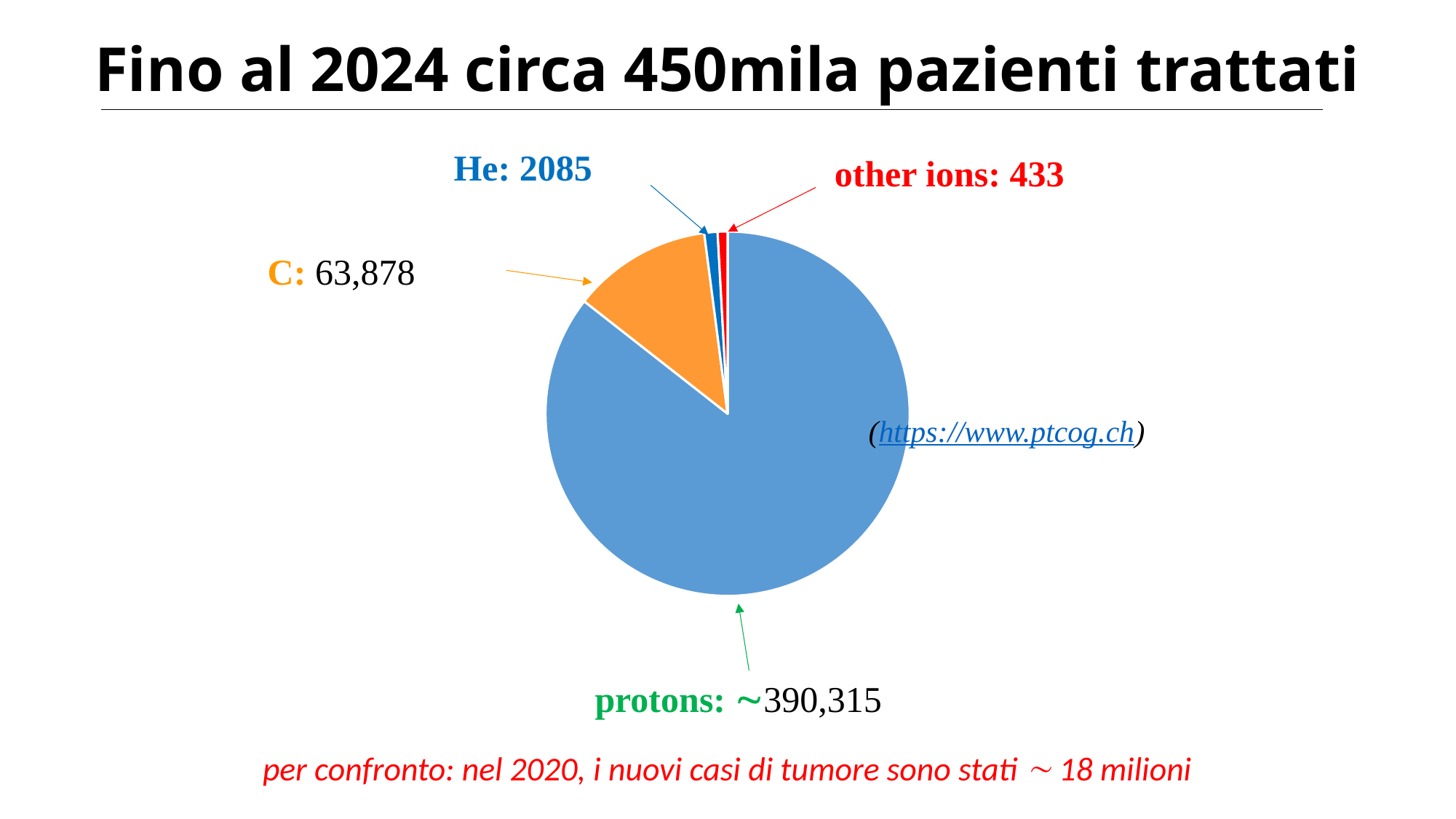
What is the value shown for other ions in the pie chart? 433 What is the difference between the values for He and other ions? 1652 What is the difference between the values for C and He? 61,793 Which is larger in the pie chart, C or He? C How many slices does the pie chart have? 4 What is the value shown for C in the pie chart? 63,878 What kind of chart is shown on the slide? pie chart What colour is the protons slice of the pie chart? blue Which category has the largest slice of the pie chart? protons What is the title of the slide containing the pie chart? Fino al 2024 circa 450mila pazienti trattati Which category has the smallest slice of the pie chart? other ions What is the value shown for He in the pie chart? 2085